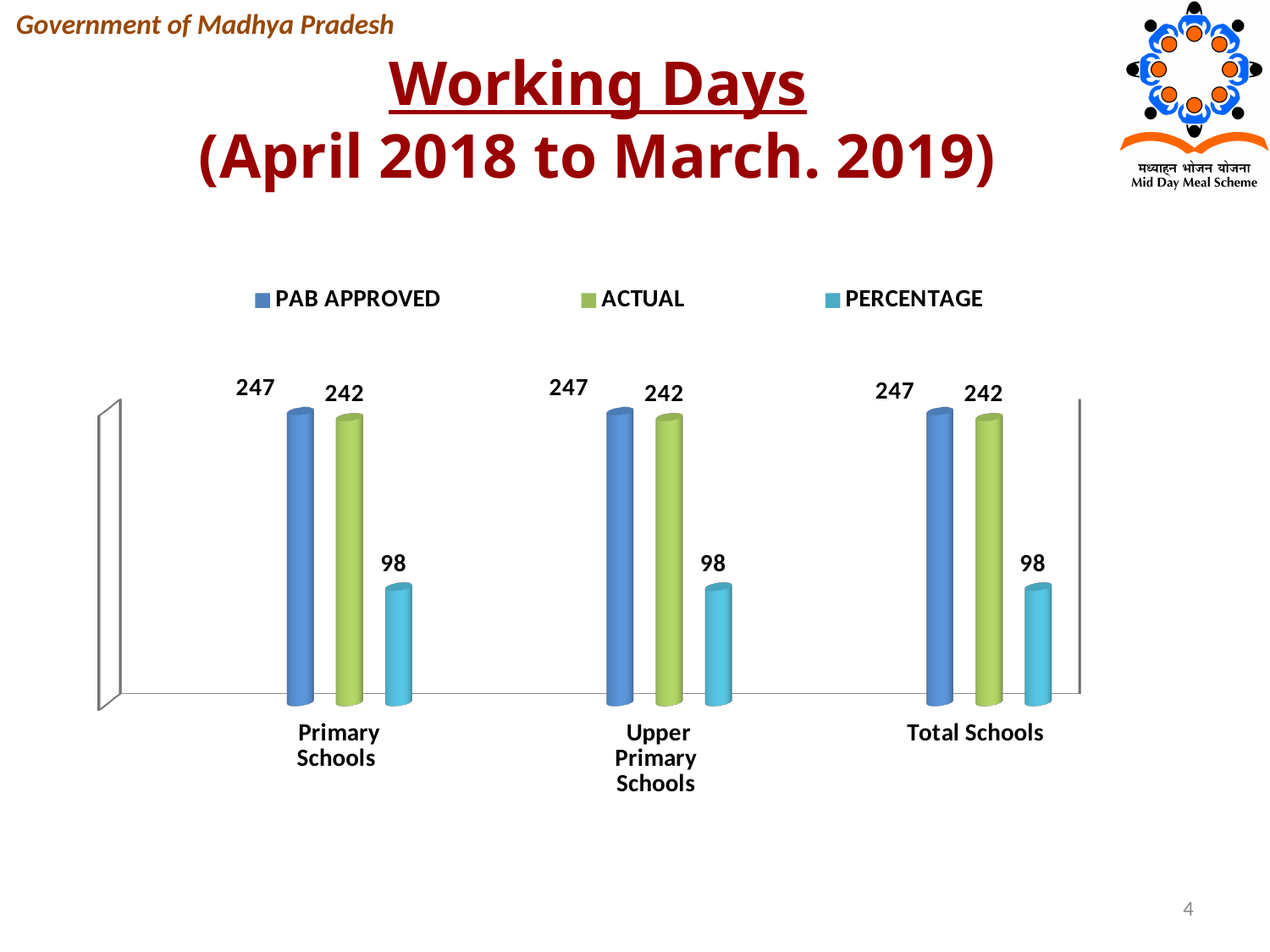
Which series has the lowest value for Total Schools? PERCENTAGE What is the ACTUAL value for Upper Primary Schools? 242 Which is larger for Upper Primary Schools, the PAB APPROVED value or the ACTUAL value? PAB APPROVED How many categories are shown on the x axis of the chart? 3 What is the ACTUAL value for Total Schools? 242 What is the PERCENTAGE value for Total Schools? 98 Which series is shown in green in the legend? ACTUAL How many series does the legend list? 3 Does the PAB APPROVED value change across the three categories? No, it stays at 247 What kind of chart is shown on the slide? Bar chart What is the PAB APPROVED value for Primary Schools? 247 What is the difference between the PAB APPROVED and ACTUAL values for Primary Schools? 5